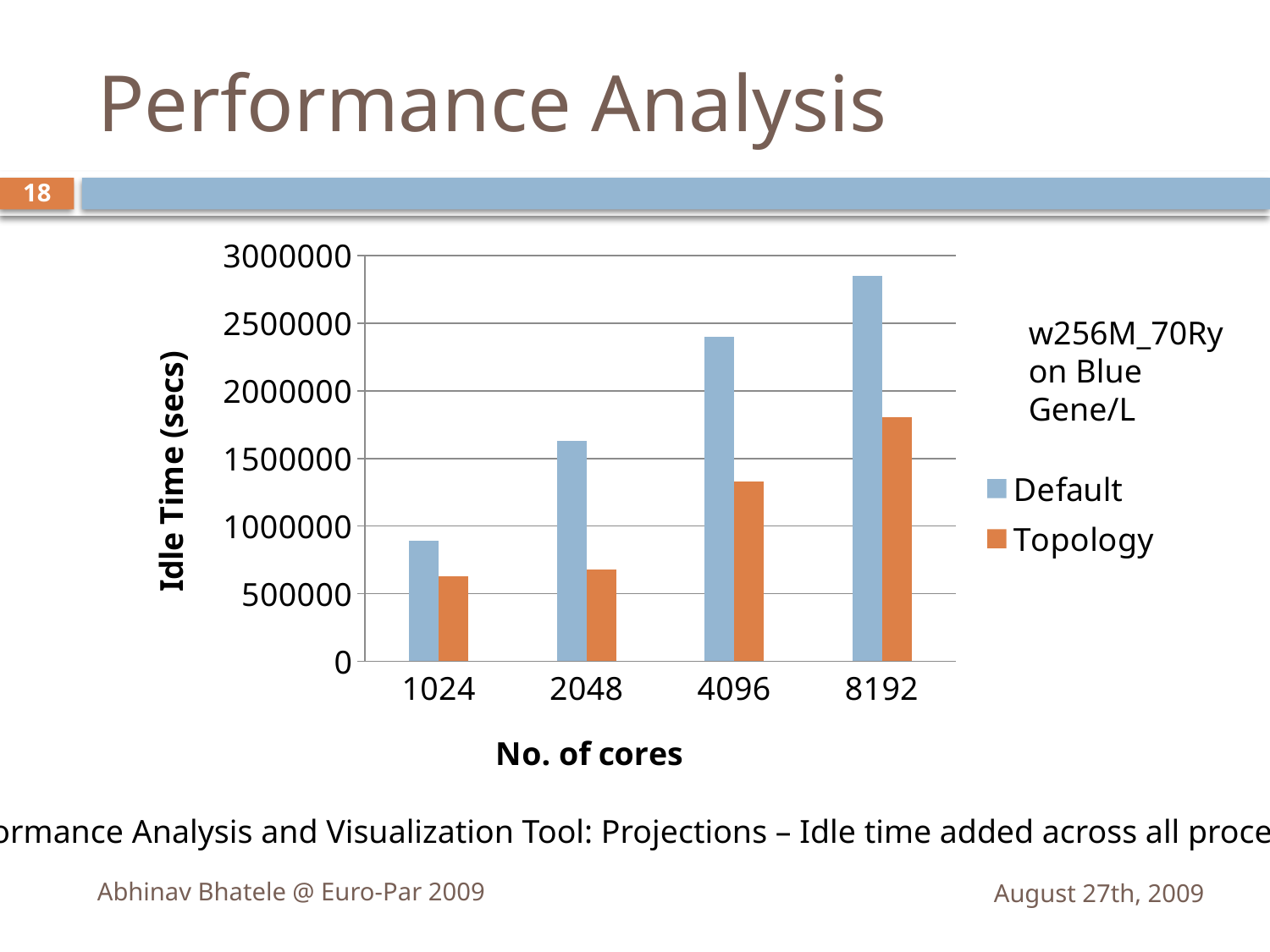
Which number of cores has the highest Default idle time? 8192 Which number of cores has the lowest Default idle time? 1024 Is the Default idle time at 1024 cores greater or less than 1000000? less Is the Topology idle time at 4096 cores greater or less than 1000000? greater What kind of chart is shown on the slide? bar chart What is the label of the y axis? Idle Time (secs) At 4096 cores, which is larger: the Default or the Topology idle time? Default Is the Topology idle time at 8192 cores greater or less than 2000000? less How many core counts are shown on the x axis? 4 How many series does the legend list? 2 Do the Default idle time values rise or fall as the number of cores increases? rise